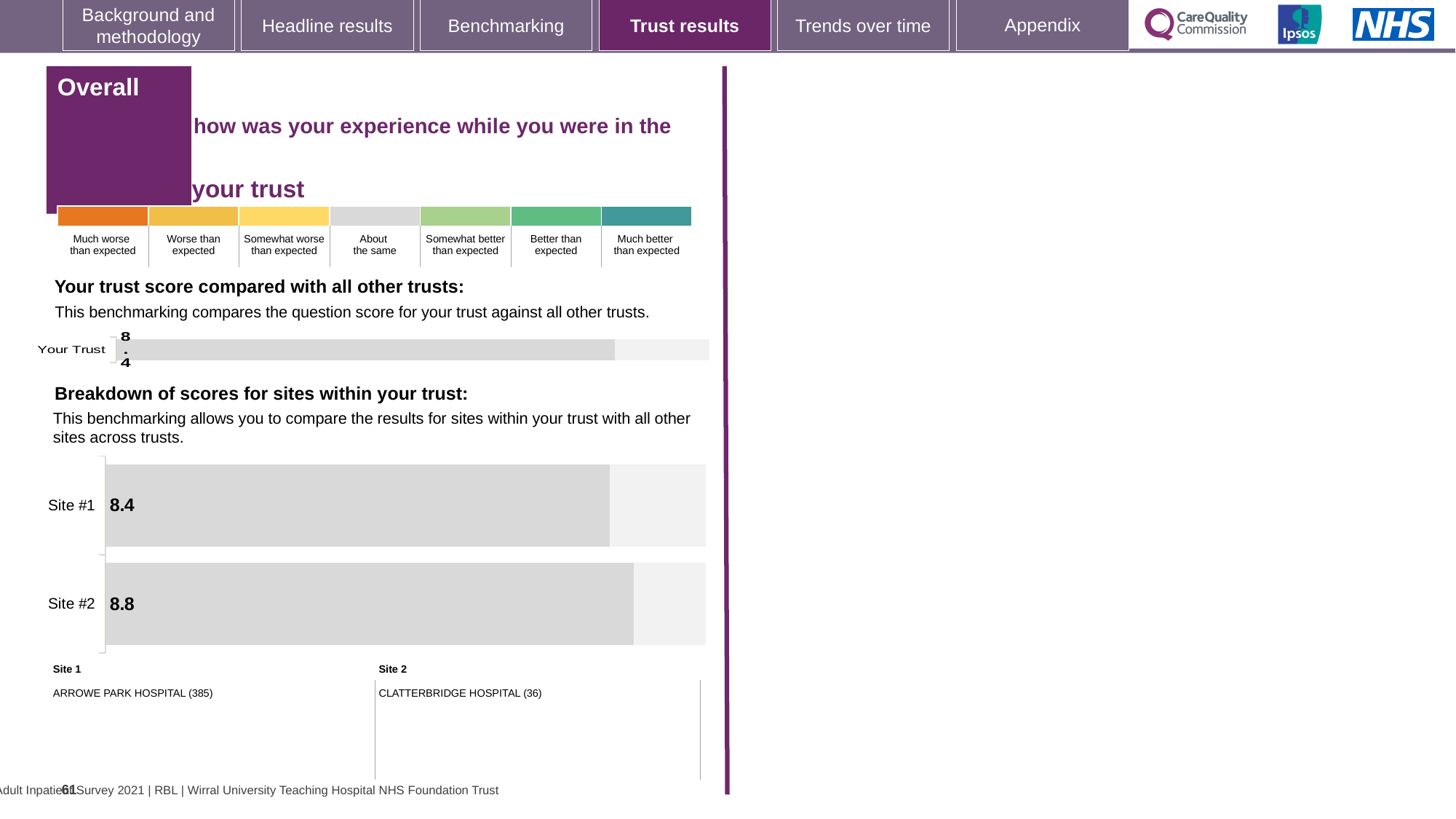
According to the site key below the charts, which hospital is Site 2? CLATTERBRIDGE HOSPITAL (36) How many bars are shown in the 'Your trust score compared with all other trusts' chart? 1 In the 'Breakdown of scores for sites within your trust' chart, what is the score for Site #2? 8.8 In the 'Breakdown of scores for sites within your trust' chart, what is the score for Site #1? 8.4 In the 'Breakdown of scores for sites within your trust' chart, is the score for Site #1 or Site #2 larger? Site #2 In the 'Breakdown of scores for sites within your trust' chart, which site has the higher score? Site #2 In the 'Breakdown of scores for sites within your trust' chart, what is the difference between the scores of Site #2 and Site #1? 0.4 In the 'Your trust score compared with all other trusts' chart, what is the score for Your Trust? 8.4 What kind of chart is the 'Breakdown of scores for sites within your trust' chart? Bar chart In the 'Breakdown of scores for sites within your trust' chart, which site has the lower score? Site #1 How many sites are plotted in the 'Breakdown of scores for sites within your trust' chart? 2 According to the site key below the charts, which hospital is Site 1? ARROWE PARK HOSPITAL (385)